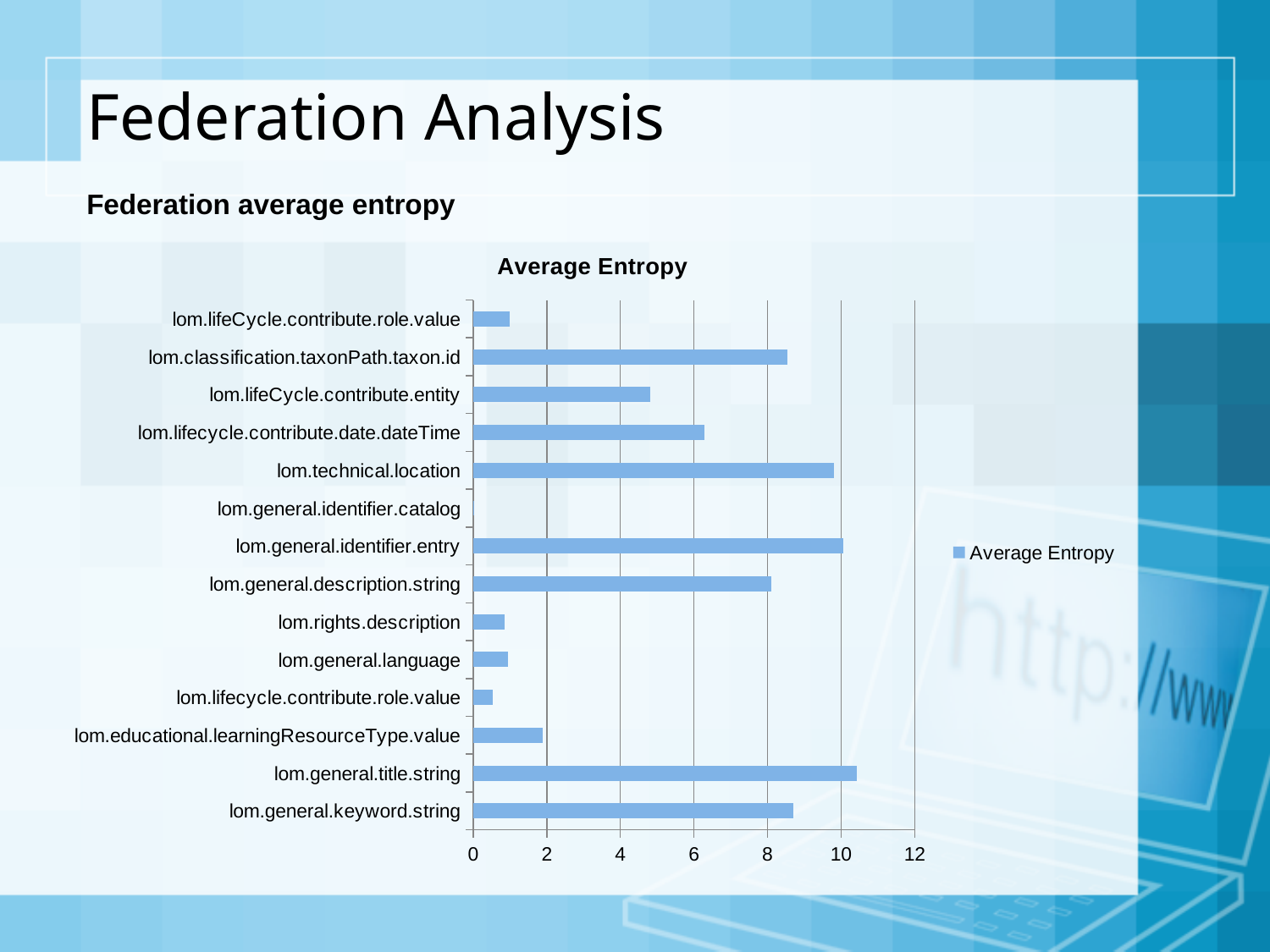
Which has a higher average entropy, lom.classification.taxonPath.taxon.id or lom.lifeCycle.contribute.entity? lom.classification.taxonPath.taxon.id How many categories are plotted on the chart? 14 Is the value for lom.educational.learningResourceType.value greater or less than 4? less Which has a higher average entropy, lom.technical.location or lom.lifecycle.contribute.date.dateTime? lom.technical.location What is the title of the chart? Average Entropy Is the value for lom.classification.taxonPath.taxon.id greater or less than 8? greater Is the value for lom.lifeCycle.contribute.entity greater or less than 6? less What is the name of the series shown in the legend? Average Entropy How many series does the legend list? 1 What kind of chart is shown on the slide? bar chart Which category has the lowest average entropy? lom.general.identifier.catalog